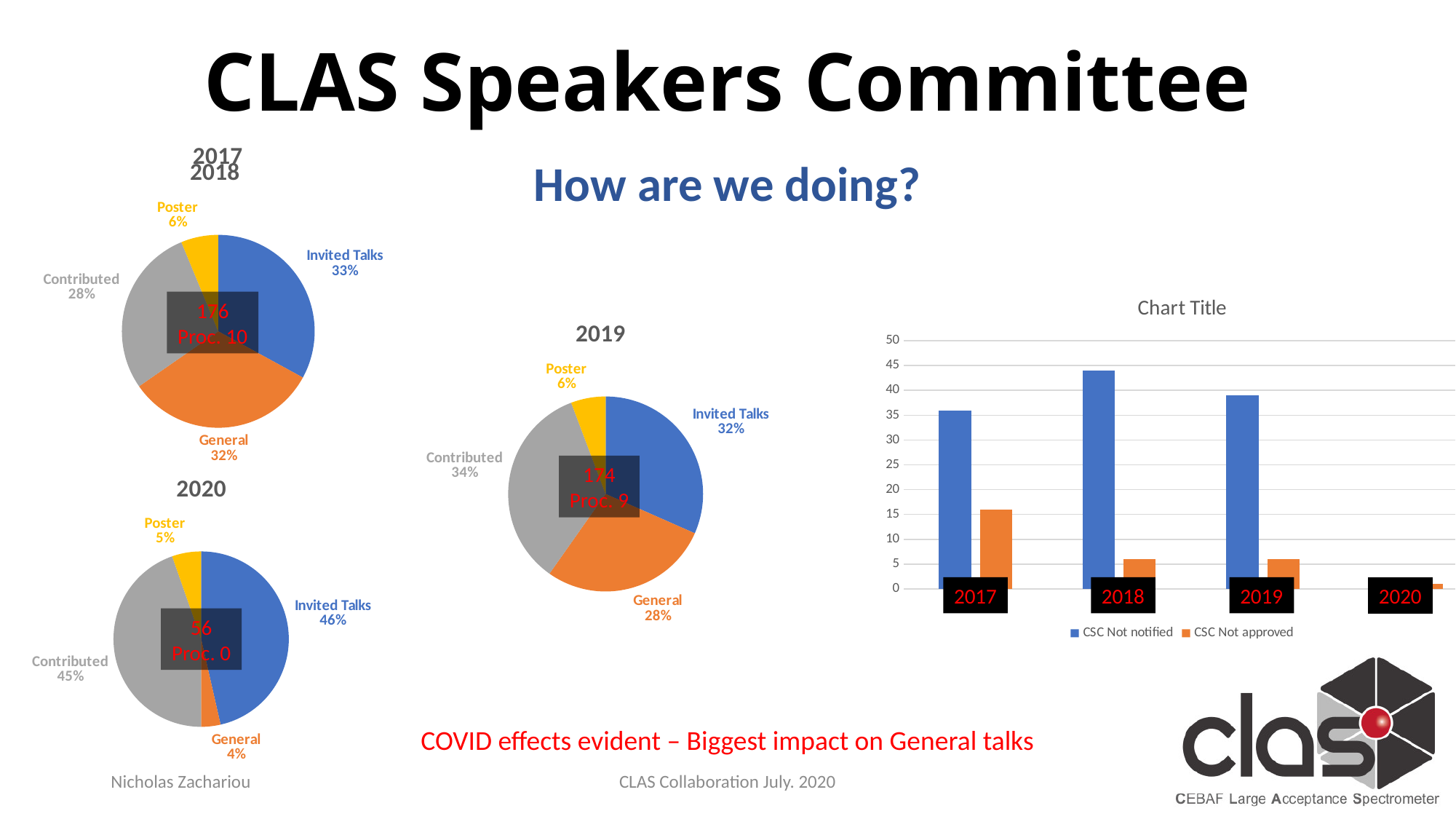
What kind of chart is the chart titled 'Chart Title' on the right of the slide? bar chart How many categories does the 2020 pie chart show? 4 In the 2019 pie chart, what share of the pie is Invited Talks? 32% In the bar chart titled 'Chart Title', how many series does the legend list? 2 In the 2017/2018 pie chart, what share of the pie is Contributed? 28% In the 2017/2018 pie chart, which is larger, Invited Talks or General? Invited Talks In the bar chart titled 'Chart Title', is the value for CSC Not approved in 2017 greater or less than 20? less In the 2019 pie chart, what is the difference in percentage points between Contributed and General? 6 In the 2019 pie chart, which category has the smallest share? Poster In the 2020 pie chart, what share of the pie is General? 4% In the 2020 pie chart, which category has the largest share? Invited Talks In the bar chart titled 'Chart Title', is the value for CSC Not notified in 2018 greater or less than 40? greater